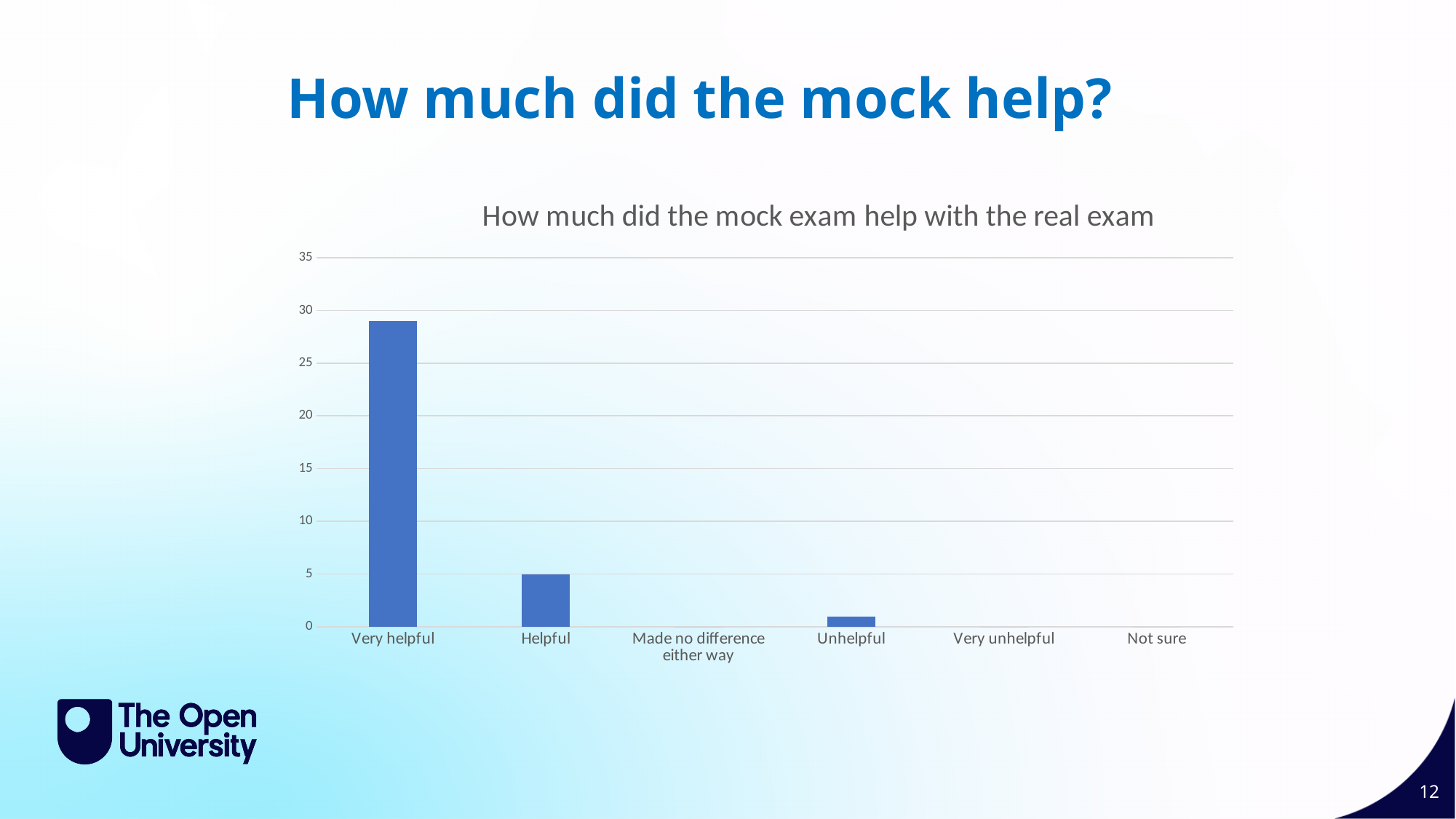
What is the value for Helpful? 5 What kind of chart is shown on the slide? bar chart Which is larger, the value for Helpful or the value for Unhelpful? Helpful What is the value for Not sure? 0 How many categories are shown on the x axis of the chart? 6 Is the value for Very helpful greater or less than 30? less Which category has the highest value? Very helpful What is the title of the chart? How much did the mock exam help with the real exam Is the value for Unhelpful greater or less than 5? less Which is larger, the value for Very helpful or the value for Helpful? Very helpful What is the value for Very unhelpful? 0 Is the value for Very helpful greater or less than 25? greater